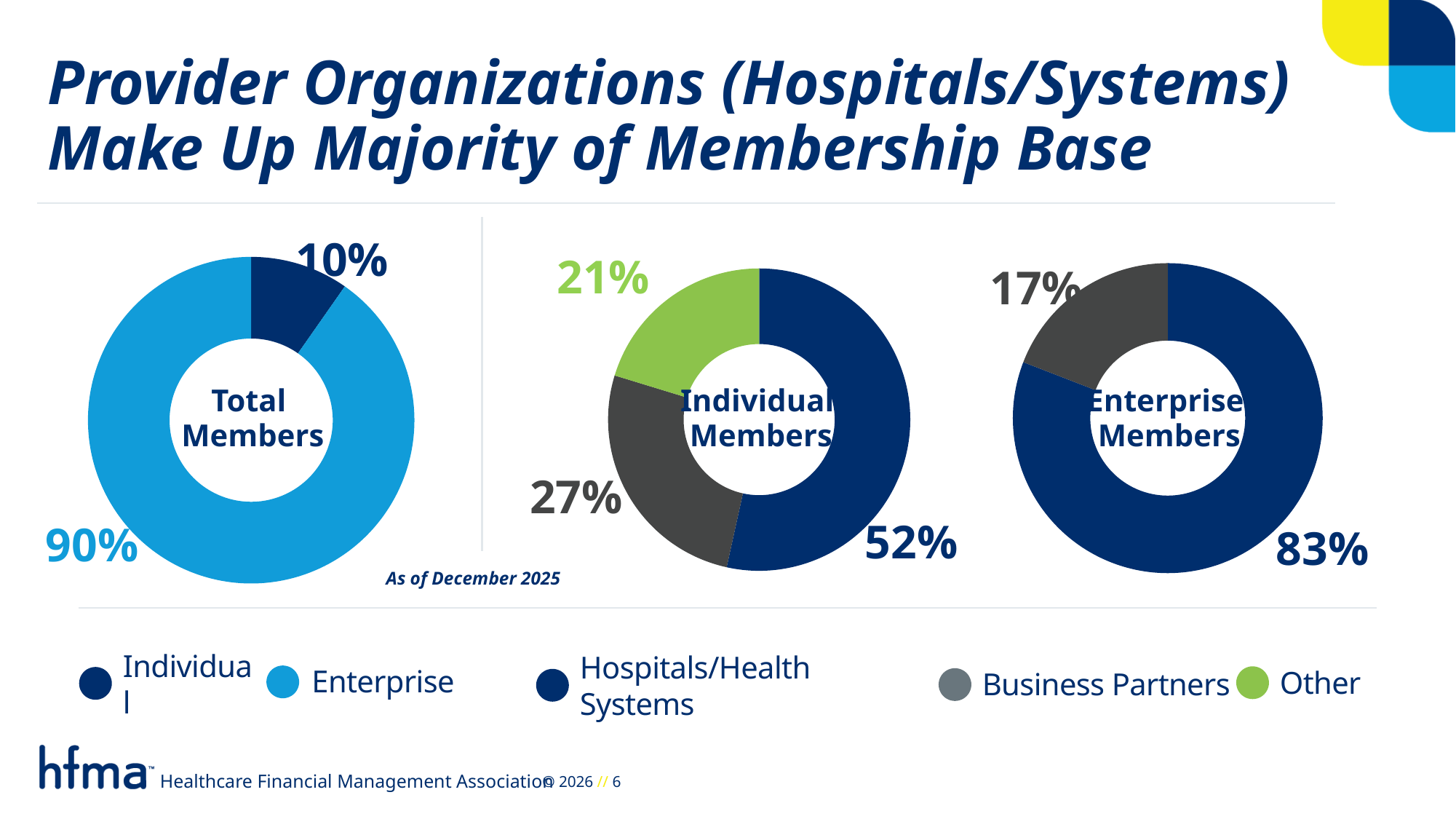
In the Individual Members chart, what share is Hospitals/Health Systems? 52% In the Enterprise Members chart, what share is Hospitals/Health Systems? 83% How many segments does the Individual Members chart have? 3 In the Individual Members chart, which segment is the smallest? Other In the Individual Members chart, what is the difference in percentage points between Hospitals/Health Systems and Business Partners? 25 In the Individual Members chart, what share is Other? 21% In the Total Members chart, what share of members are Individual? 10% In the Total Members chart, what share of members are Enterprise? 90% In the Enterprise Members chart, what share is Business Partners? 17% In the Individual Members chart, what share is Business Partners? 27% What kind of chart is the Total Members chart? Donut chart In the Enterprise Members chart, which is larger, Hospitals/Health Systems or Business Partners? Hospitals/Health Systems